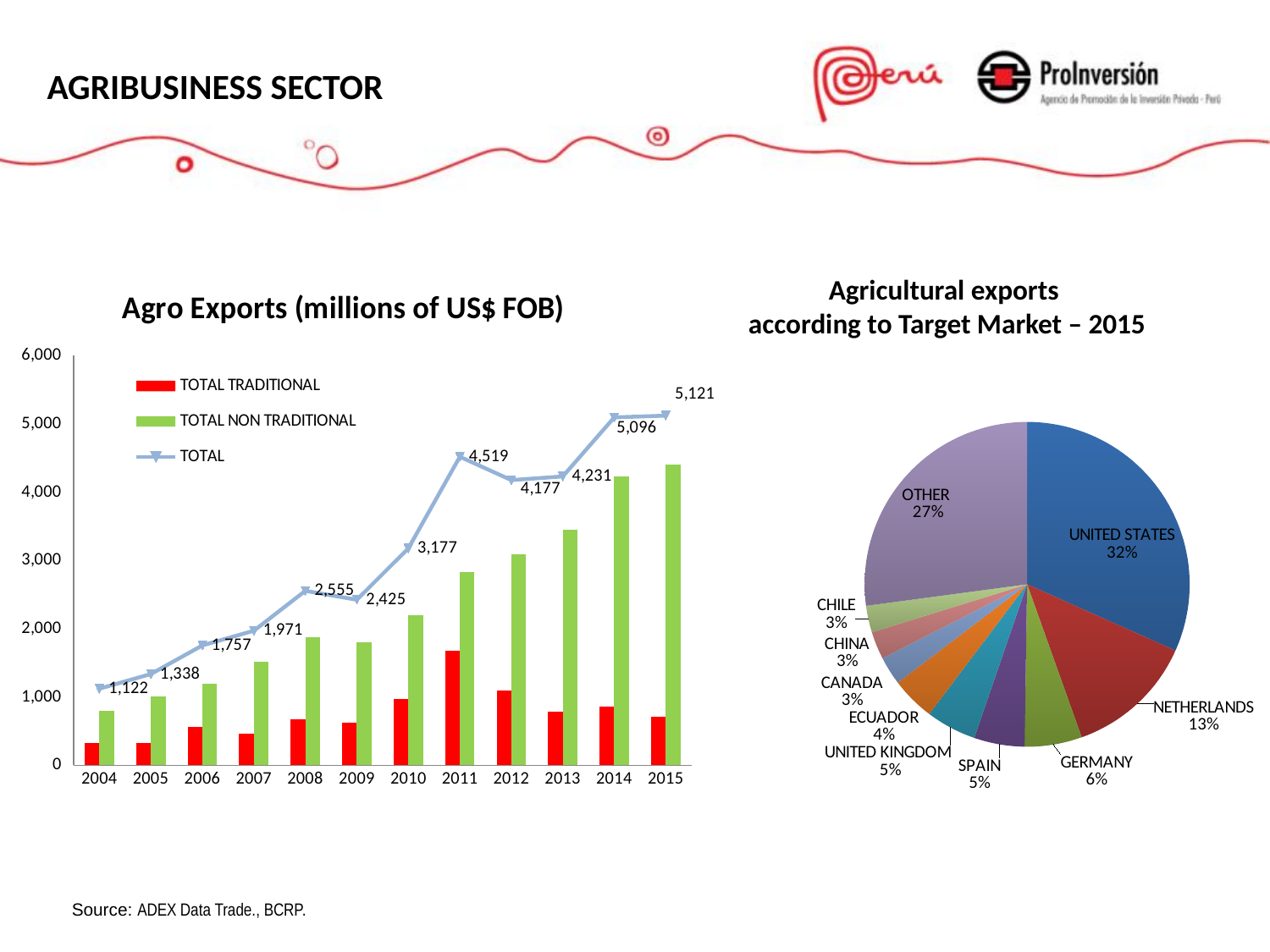
In the Agro Exports chart, which year has the lowest TOTAL? 2004 In the Agro Exports chart, by how much did the TOTAL increase from 2014 to 2015? 25 In the Agro Exports chart, how many series does the legend list? 3 In the Agricultural exports according to Target Market – 2015 pie chart, what share goes to the United States? 32% In the Agro Exports chart, what is the TOTAL value for 2008? 2,555 In the Agricultural exports according to Target Market – 2015 pie chart, what share goes to the Netherlands? 13% In the Agro Exports chart, is the TOTAL NON TRADITIONAL value for 2015 greater or less than 4,000? greater In the Agro Exports chart, which year has the larger TOTAL, 2012 or 2013? 2013 In the Agricultural exports according to Target Market – 2015 pie chart, which named country has the largest slice? United States In the Agro Exports chart, what is the TOTAL value for 2015? 5,121 In the Agro Exports chart, how many years are shown on the x axis? 12 In the Agro Exports chart, which year has the highest TOTAL? 2015